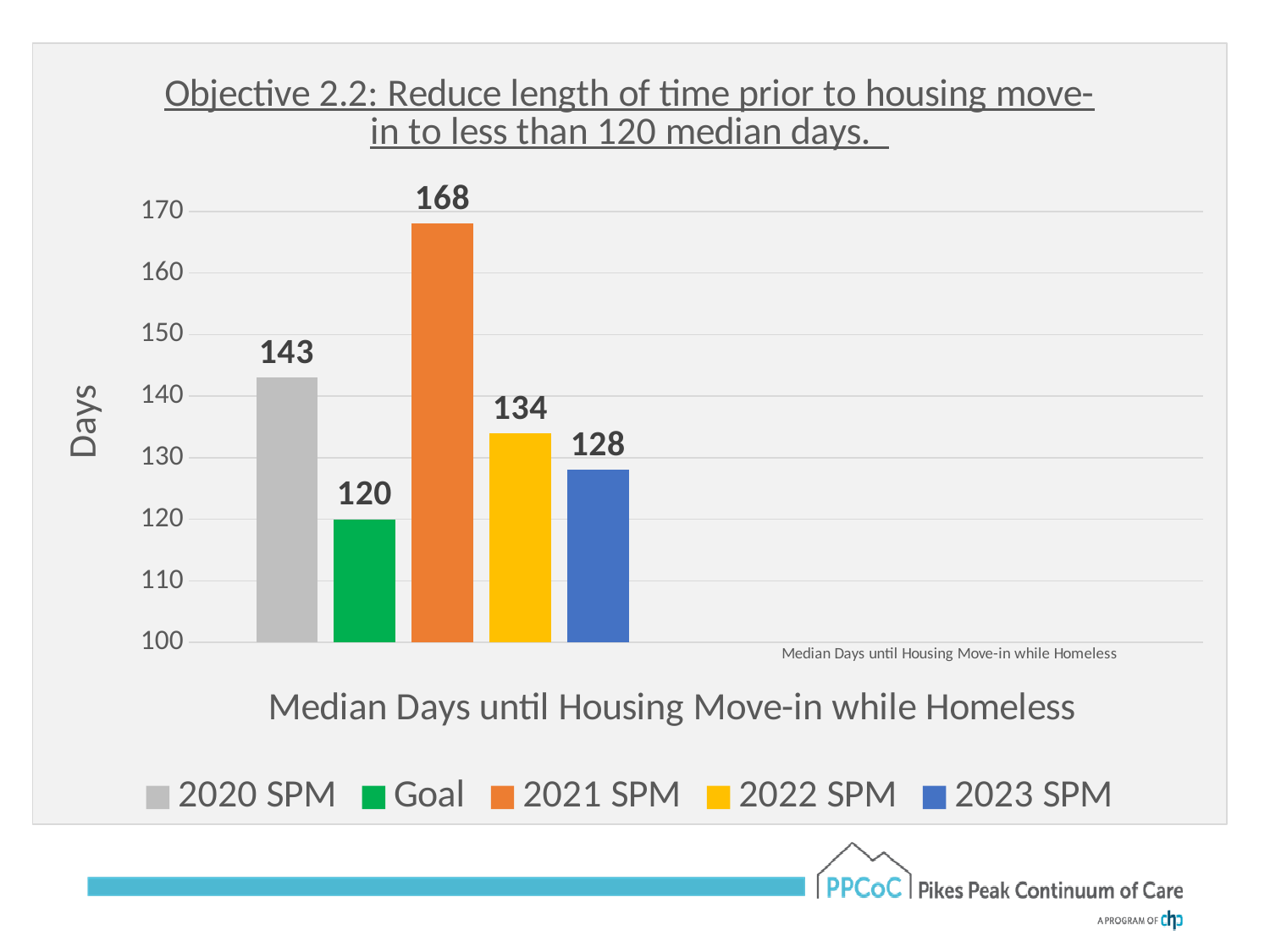
Which series has the lowest value? Goal What is the difference between the 2023 SPM value and the Goal value? 8 What kind of chart is shown on the slide? bar chart What is the difference between the 2021 SPM value and the 2022 SPM value? 34 What is the value for the Goal series? 120 Which series has the highest value? 2021 SPM Which is larger, the value for 2020 SPM or the value for 2022 SPM? 2020 SPM How many series does the legend list? 5 What is the value for 2023 SPM? 128 Is the value for 2020 SPM greater or less than 140? greater What is the label on the vertical axis? Days What is the value for 2021 SPM? 168